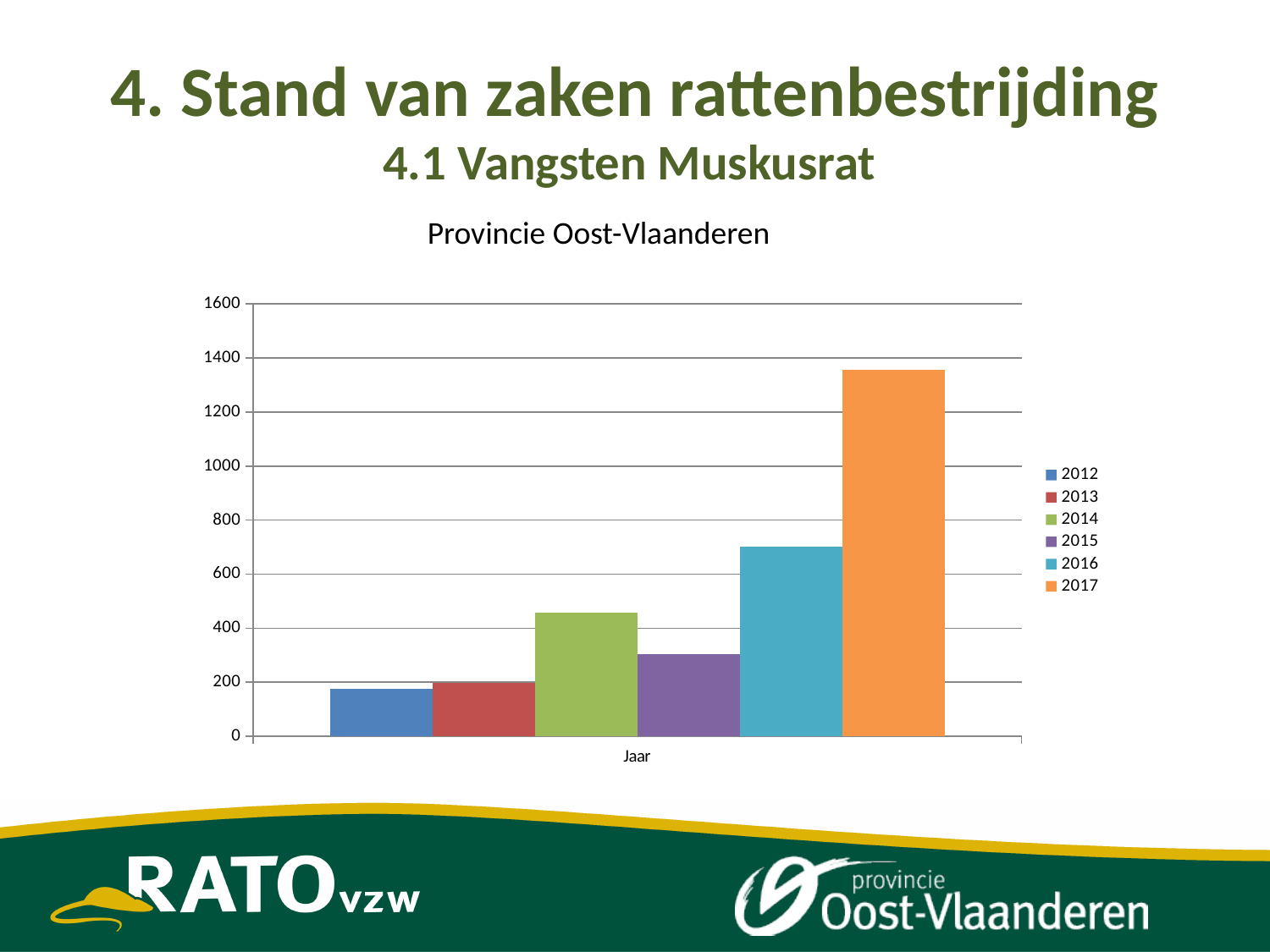
Is the value for 2016 greater or less than 800? less Which year has the lowest value? 2012 Is the value for 2015 greater or less than 400? less What is the title of the chart? Provincie Oost-Vlaanderen How many series does the legend list? 6 Does the value rise or fall from 2016 to 2017? rise Is the value for 2014 greater or less than 400? greater How many bars are plotted in the chart? 6 Which is larger, the value for 2014 or the value for 2015? 2014 What kind of chart is shown on the slide? bar chart Which year has the highest value? 2017